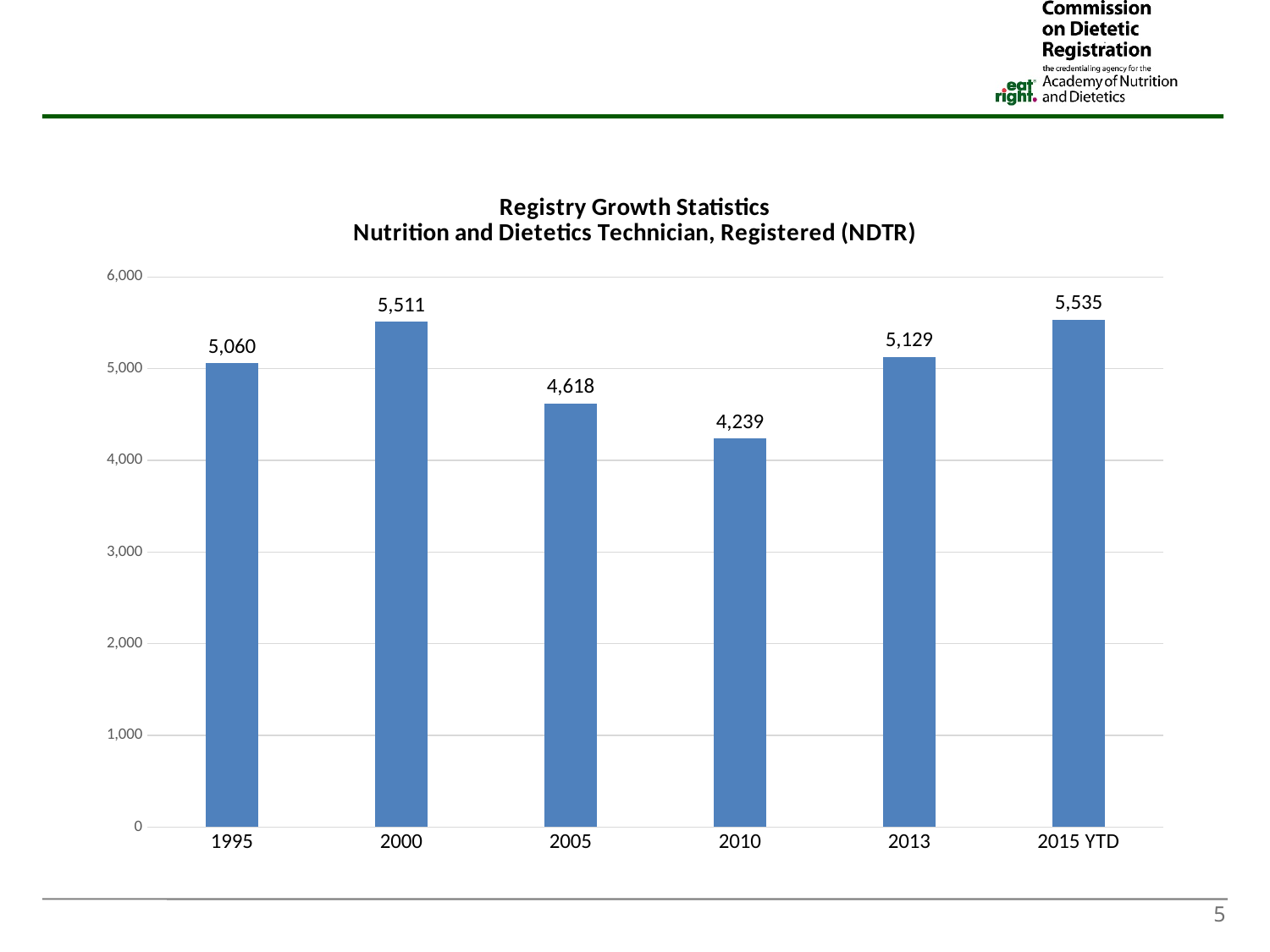
What is the value for 2010? 4,239 What kind of chart is shown? bar chart Which year has the highest value? 2015 YTD Which year has the lowest value? 2010 What is the title of the chart? Registry Growth Statistics Nutrition and Dietetics Technician, Registered (NDTR) What is the value for 2015 YTD? 5,535 What is the difference between the values for 2000 and 2005? 893 What is the value for 1995? 5,060 How many years are shown on the x axis? 6 What is the difference between the values for 2013 and 2010? 890 Is the value for 2005 greater or less than 5,000? less Which is larger, the value for 1995 or the value for 2013? 2013